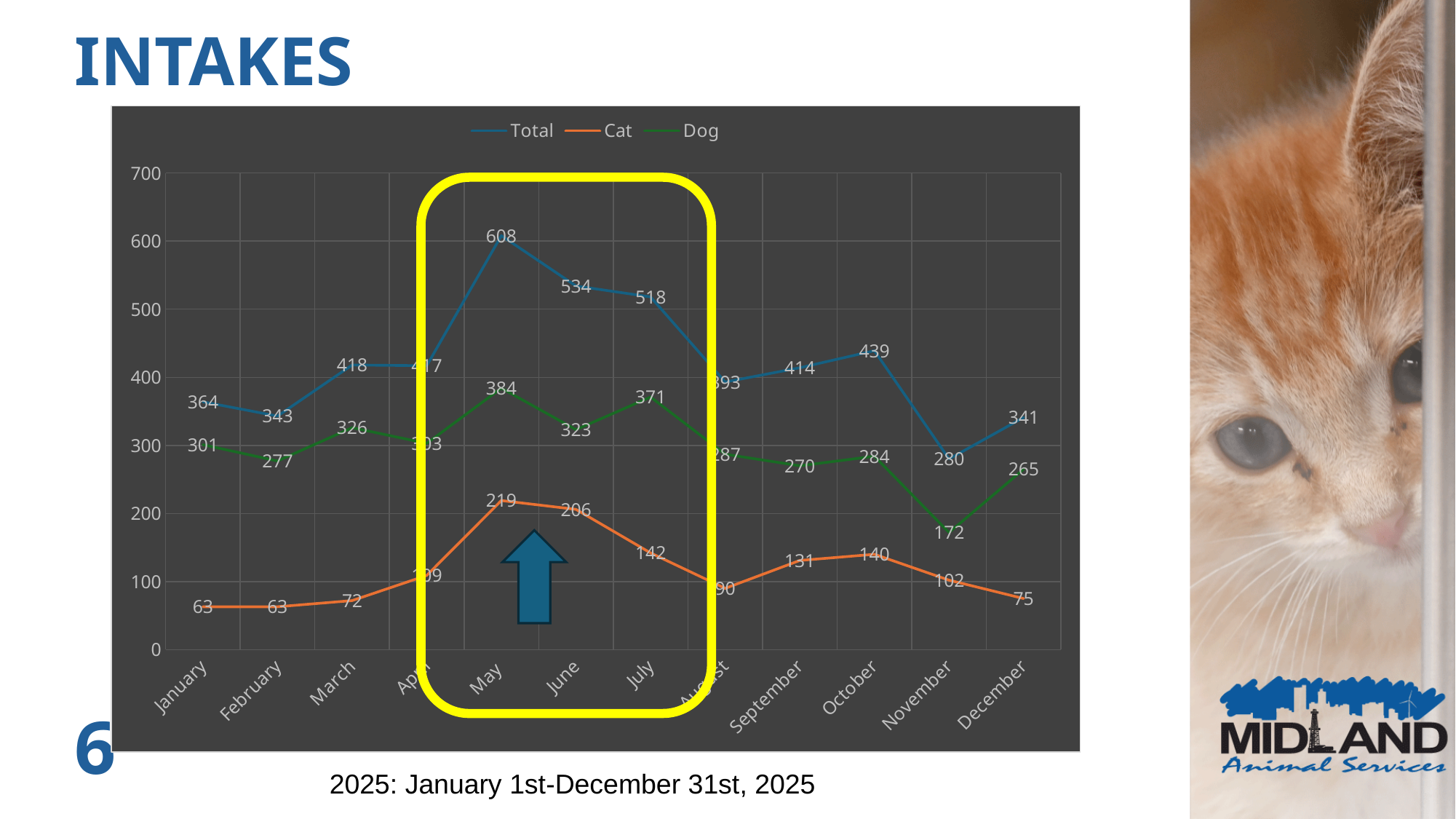
Does the Cat intake rise or fall from January to May? rise What type of chart is shown on the slide? line chart What is the difference between the Total intake in May and the Total intake in June? 74 How many months are plotted on the x axis? 12 In which month is the Dog intake lowest? November What is the Dog intake value for November? 172 Which is larger, the Cat intake in July or the Cat intake in October? July What is the Total intake value for May? 608 How many series does the legend list? 3 What is the Cat intake value for June? 206 Which series is drawn in orange? Cat In which month is the Total intake highest? May